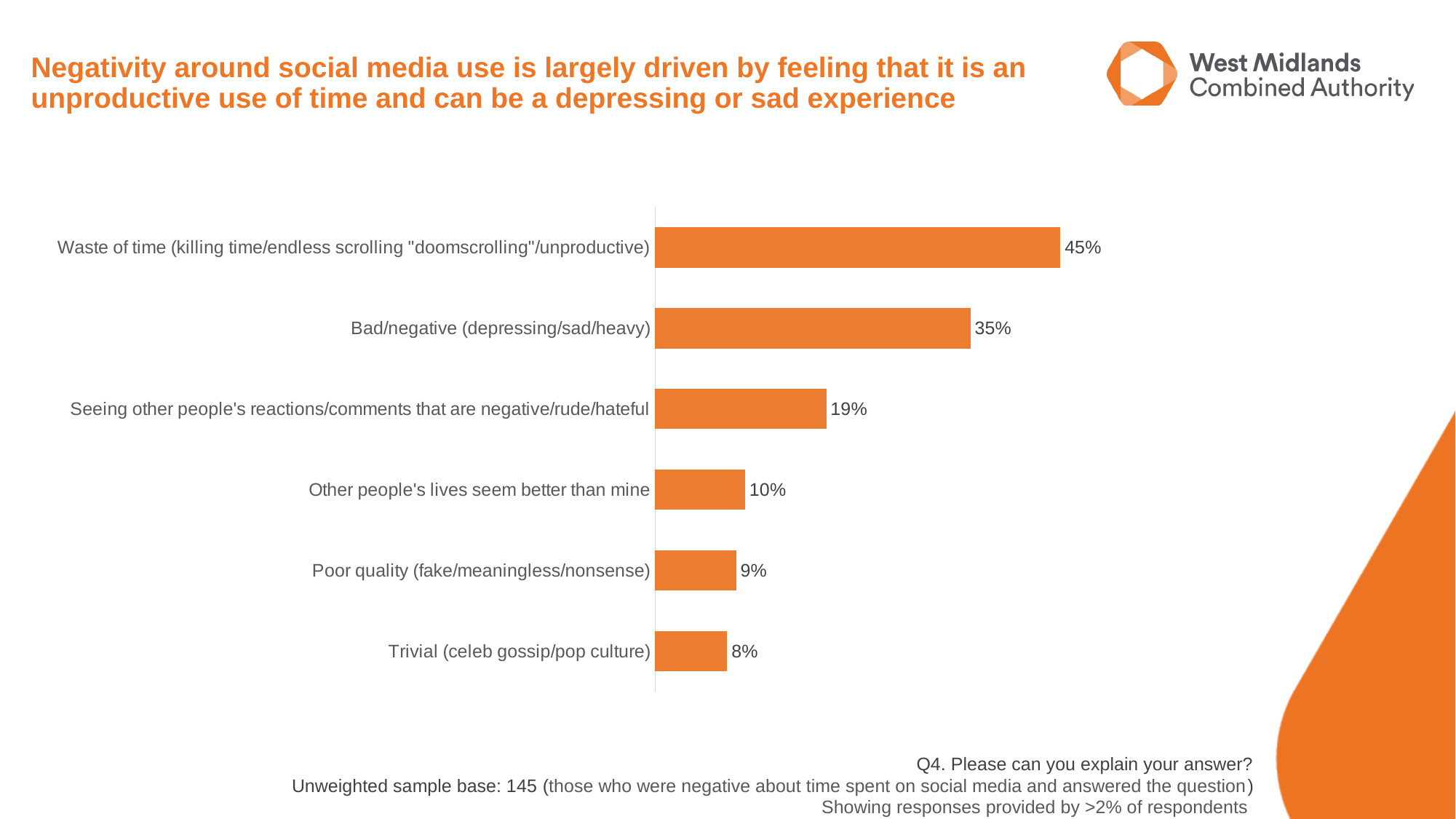
Which is larger: the value for "Bad/negative (depressing/sad/heavy)" or for "Seeing other people's reactions/comments that are negative/rude/hateful"? Bad/negative (depressing/sad/heavy) What percentage is shown for "Seeing other people's reactions/comments that are negative/rude/hateful"? 19% How many categories are shown in the chart? 6 What is the value for "Bad/negative (depressing/sad/heavy)"? 35% What percentage of respondents cited "Waste of time (killing time/endless scrolling "doomscrolling"/unproductive)"? 45% What is the unweighted sample base stated below the chart? 145 Which category has the lowest value? Trivial (celeb gossip/pop culture) Which category has the highest value? Waste of time (killing time/endless scrolling "doomscrolling"/unproductive) What type of chart is shown on the slide? Bar chart What is the difference between "Other people's lives seem better than mine" and "Poor quality (fake/meaningless/nonsense)"? 1% What is the difference between the values for "Waste of time" and "Bad/negative"? 10% What is the value for "Trivial (celeb gossip/pop culture)"? 8%